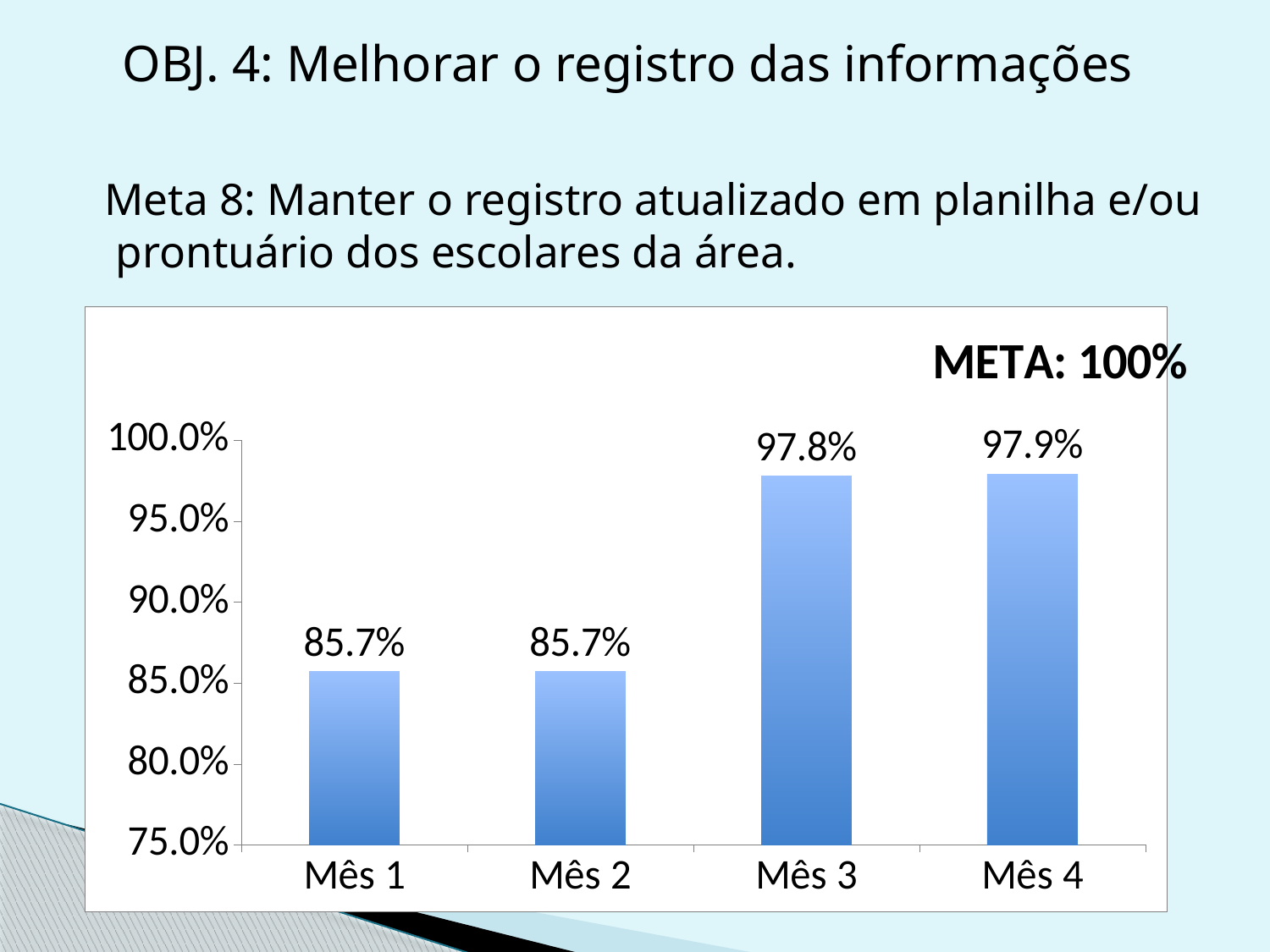
How many months are shown on the x axis? 4 What is the value for Mês 4? 97.9% What is the difference between the values for Mês 4 and Mês 2? 12.2 percentage points What is the value for Mês 3? 97.8% What target (META) is stated on the chart? 100% Which is larger, the value for Mês 2 or the value for Mês 3? Mês 3 What is the difference between the values for Mês 3 and Mês 1? 12.1 percentage points Is the value for Mês 1 greater or less than 90.0%? less What is the value for Mês 1? 85.7% What kind of chart is shown on the slide? Bar chart Is the value for Mês 3 greater or less than 95.0%? greater Which month has the highest value? Mês 4